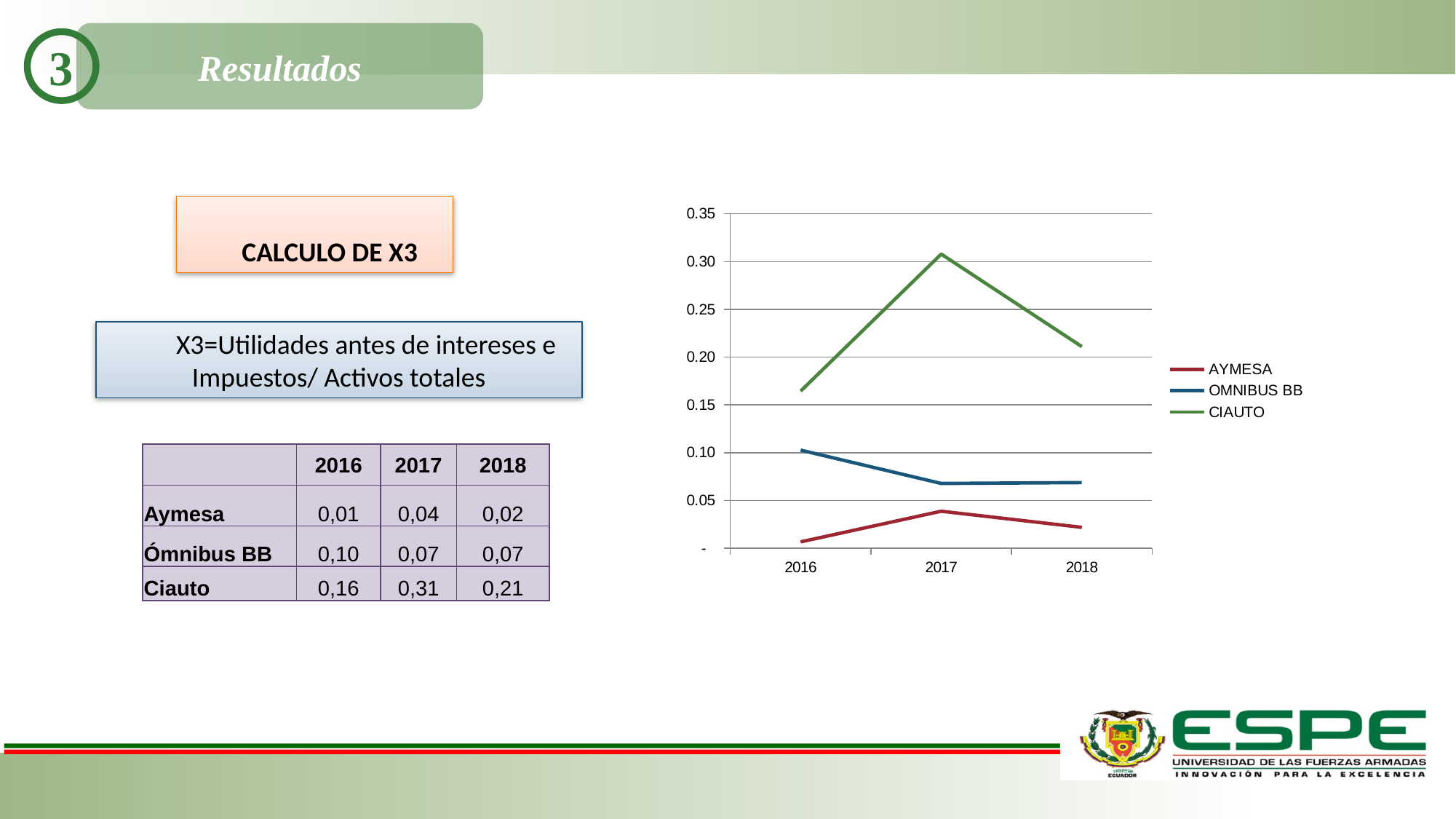
Does the OMNIBUS BB line rise or fall from 2016 to 2017? fall How many series does the legend of the line chart list? 3 Which series has the lowest value in 2016 on the line chart? AYMESA Is the value for OMNIBUS BB in 2017 greater or less than 0.10? less How many years are plotted along the x axis of the line chart? 3 What colour is the CIAUTO line in the chart legend? green Is the value for CIAUTO in 2017 greater or less than 0.25? greater In 2017, which is larger: the value for AYMESA or the value for OMNIBUS BB? OMNIBUS BB What kind of chart is shown on the right of the slide? line chart According to the table on the slide, what is the X3 value for Ciauto in 2017? 0,31 Which series has the highest value in 2017 on the line chart? CIAUTO Does the CIAUTO line rise or fall from 2017 to 2018? fall